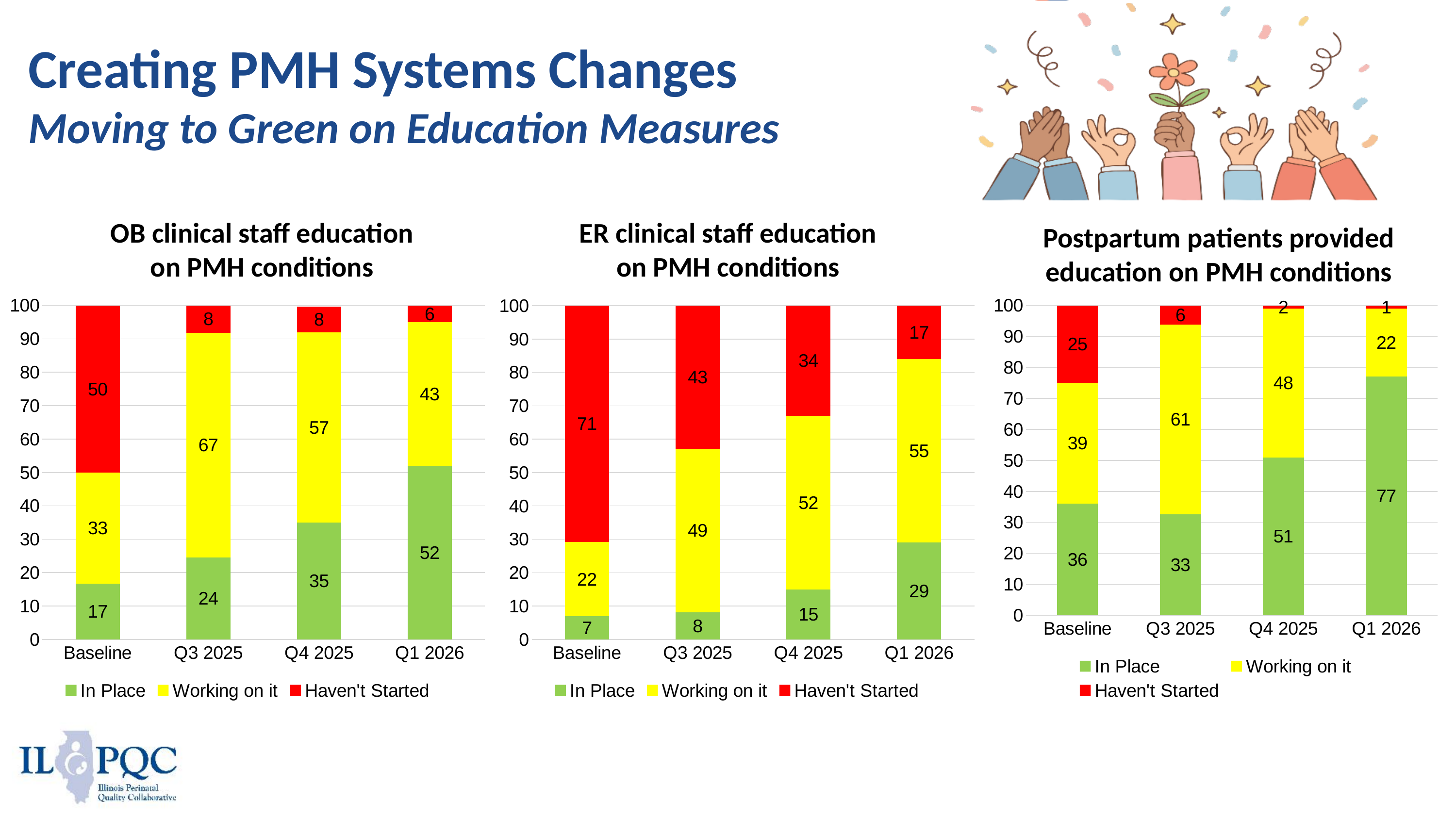
In the 'ER clinical staff education on PMH conditions' chart, what is the 'Haven't Started' value at Baseline? 71 In the 'Postpartum patients provided education on PMH conditions' chart, which period has the highest 'In Place' value? Q1 2026 In the 'ER clinical staff education on PMH conditions' chart, is the 'Working on it' value larger for Q3 2025 or Q1 2026? Q1 2026 In the 'Postpartum patients provided education on PMH conditions' chart, what is the total of the Baseline stacked bar? 100 In the 'OB clinical staff education on PMH conditions' chart, what is the difference between the 'In Place' values for Q1 2026 and Baseline? 35 How many series does the legend of the 'Postpartum patients provided education on PMH conditions' chart list? 3 In the 'ER clinical staff education on PMH conditions' chart, does the 'Haven't Started' value rise or fall from Baseline to Q1 2026? Fall What kind of chart is the 'ER clinical staff education on PMH conditions' chart? Stacked bar chart In the 'ER clinical staff education on PMH conditions' chart, which period has the lowest 'In Place' value? Baseline In the 'Postpartum patients provided education on PMH conditions' chart, what is the 'Working on it' value for Q3 2025? 61 In the 'OB clinical staff education on PMH conditions' chart, what is the 'In Place' value for Q1 2026? 52 How many periods are shown on the x axis of the 'OB clinical staff education on PMH conditions' chart? 4